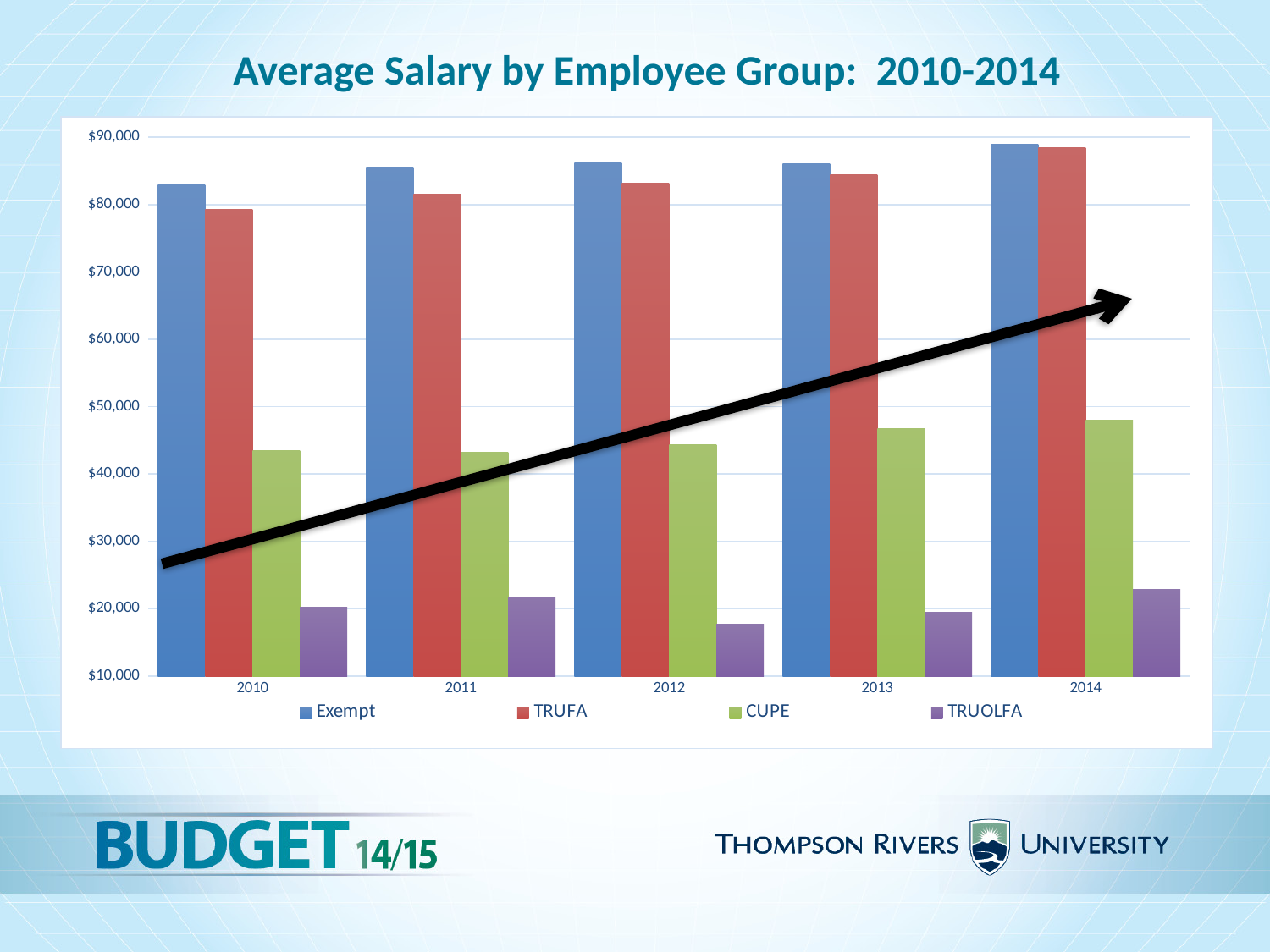
Is the TRUOLFA average salary in 2012 greater or less than $20,000? less In 2010, which group has the higher average salary, Exempt or TRUFA? Exempt What is the title of the chart? Average Salary by Employee Group: 2010-2014 Is the TRUFA average salary in 2010 greater or less than $80,000? less How many series does the legend list? 4 Does the TRUFA average salary rise or fall from 2010 to 2014? rise In which year is the TRUOLFA average salary lowest? 2012 Is the Exempt average salary in 2010 greater or less than $80,000? greater How many years are shown on the x axis? 5 What kind of chart is shown on the slide? bar chart Which employee group has the lowest average salary in every year shown? TRUOLFA